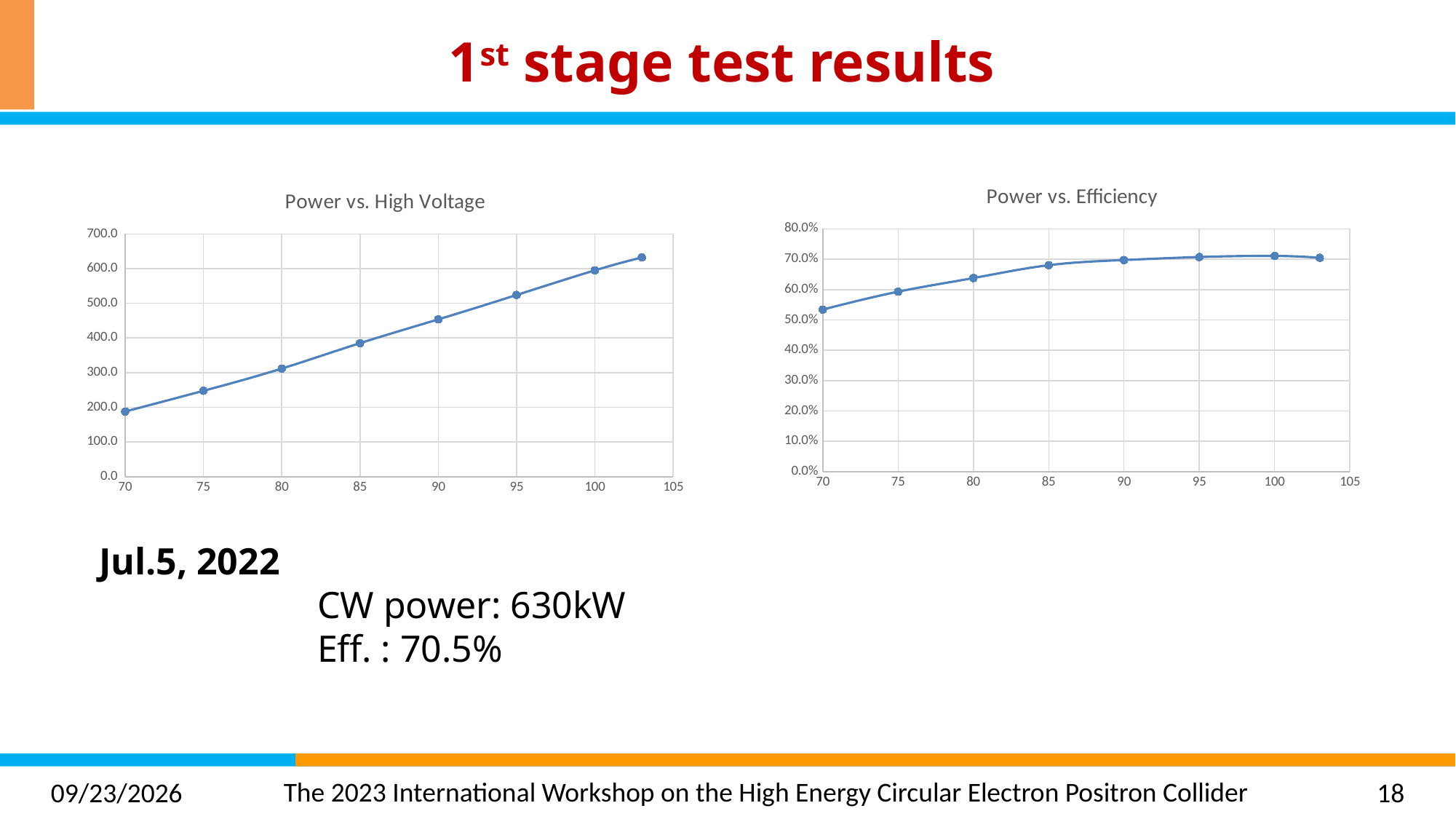
In the 'Power vs. Efficiency' chart, is the value at x = 80 greater or less than 60.0%? greater In the 'Power vs. High Voltage' chart, at which x-axis value is the plotted value lowest? 70 In the 'Power vs. Efficiency' chart, which is larger: the value at x = 70 or the value at x = 90? x = 90 In the 'Power vs. Efficiency' chart, at which x-axis value is the plotted value lowest? 70 In the 'Power vs. High Voltage' chart, how many data points are plotted? 8 In the 'Power vs. Efficiency' chart, how many data points are plotted? 8 What kind of chart is the 'Power vs. High Voltage' chart? line chart What kind of chart is the 'Power vs. Efficiency' chart? line chart In the 'Power vs. High Voltage' chart, do the values rise or fall as the x-axis value increases? rise In the 'Power vs. High Voltage' chart, is the value at x = 85 greater or less than 300? greater In the 'Power vs. High Voltage' chart, is the value at x = 100 greater or less than 500? greater